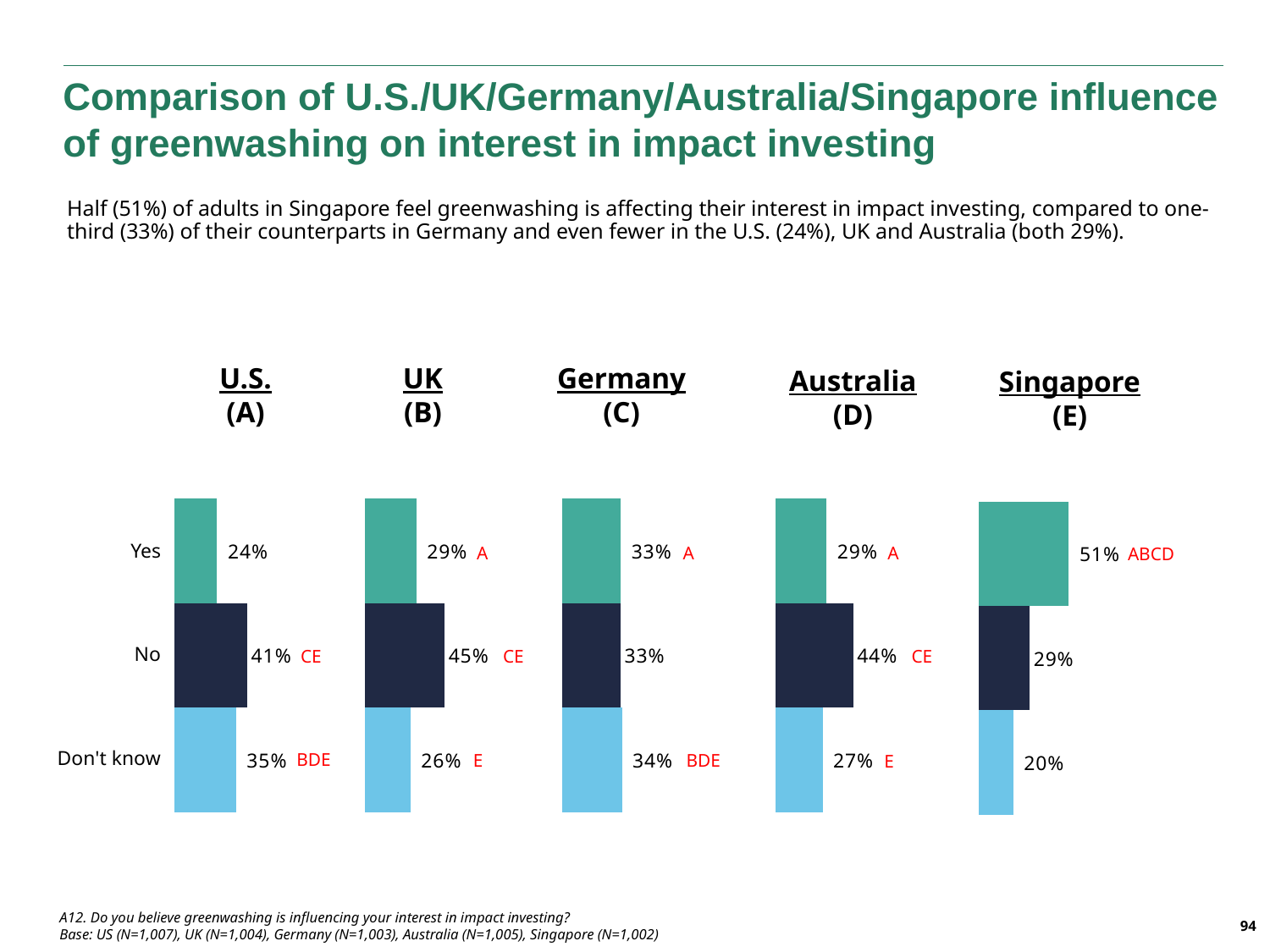
In the U.S. (A) chart, what percentage answered Yes? 24% How many countries are compared on the slide? 5 In the UK (B) chart, which response category has the highest percentage? No What is the total of the three percentages shown in the U.S. (A) chart? 100% Across the five country charts, which country has the highest Yes percentage? Singapore Which is larger: the No percentage in the U.S. (A) chart or the No percentage in the Singapore (E) chart? U.S. (A) In the Singapore (E) chart, what percentage answered Don't know? 20% What is the difference between the Yes percentage for Singapore (E) and the Yes percentage for Germany (C)? 18 percentage points In the Germany (C) chart, what percentage answered No? 33% How many response categories are shown in each country chart? 3 What kind of chart is used to show the responses for each country? Bar chart Across the five country charts, which country has the lowest Yes percentage? U.S.